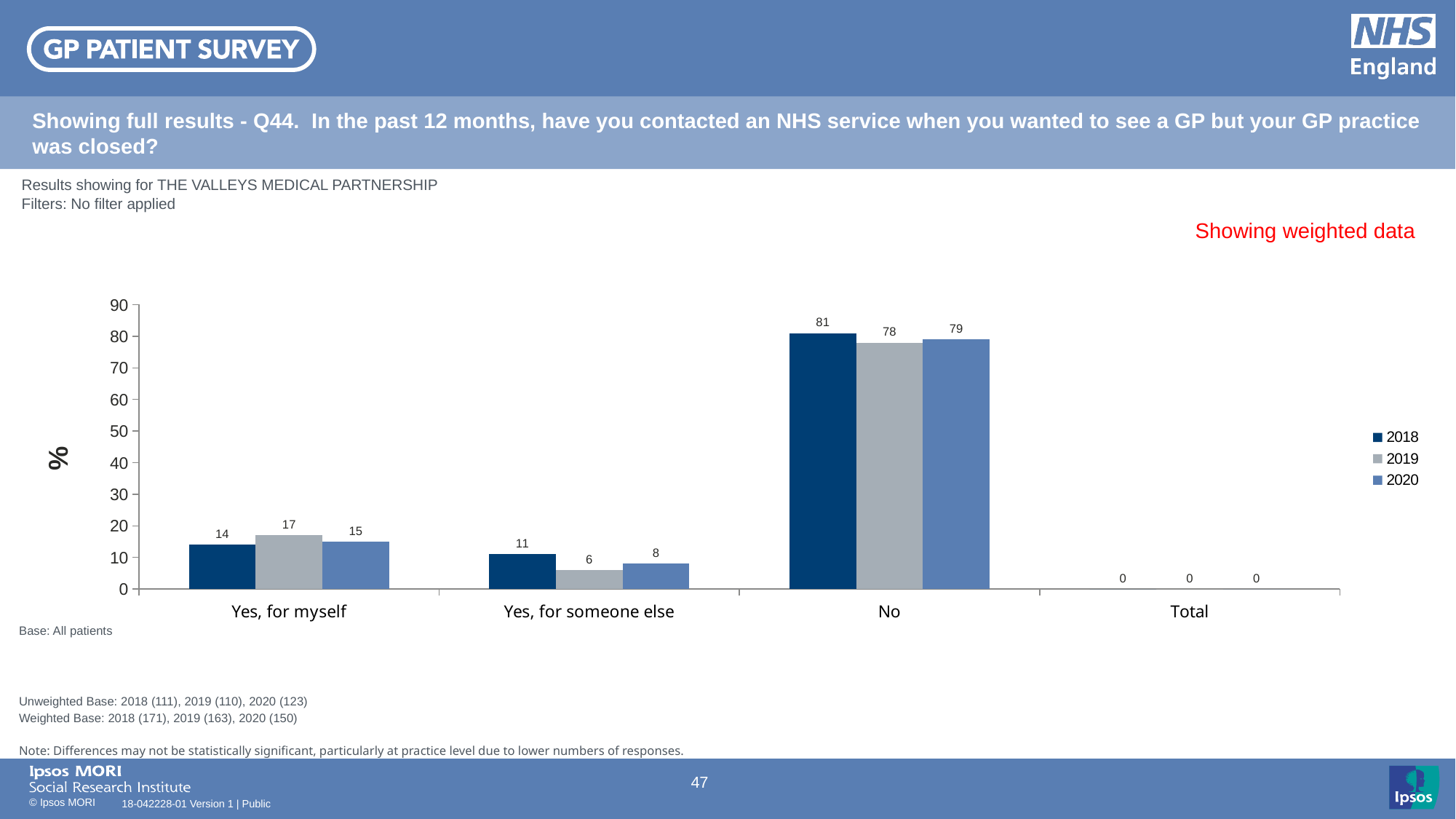
How many categories are shown on the x axis? 4 What label is shown on the y axis? % What kind of chart is shown on the slide? Bar chart Which year has the lowest value in the 'Yes, for someone else' category? 2019 Which is larger: the 2019 value for 'Yes, for myself' or the 2020 value for 'Yes, for myself'? 2019 Is the 2018 value for 'No' greater or less than 80? greater What is the value for 2018 in the 'Yes, for myself' category? 14 Which category has the highest value for 2020? No What is the value for 2020 in the 'Yes, for someone else' category? 8 How many series does the legend list? 3 What is the difference between the 2018 and 2019 values in the 'No' category? 3 What is the value for 2019 in the 'No' category? 78